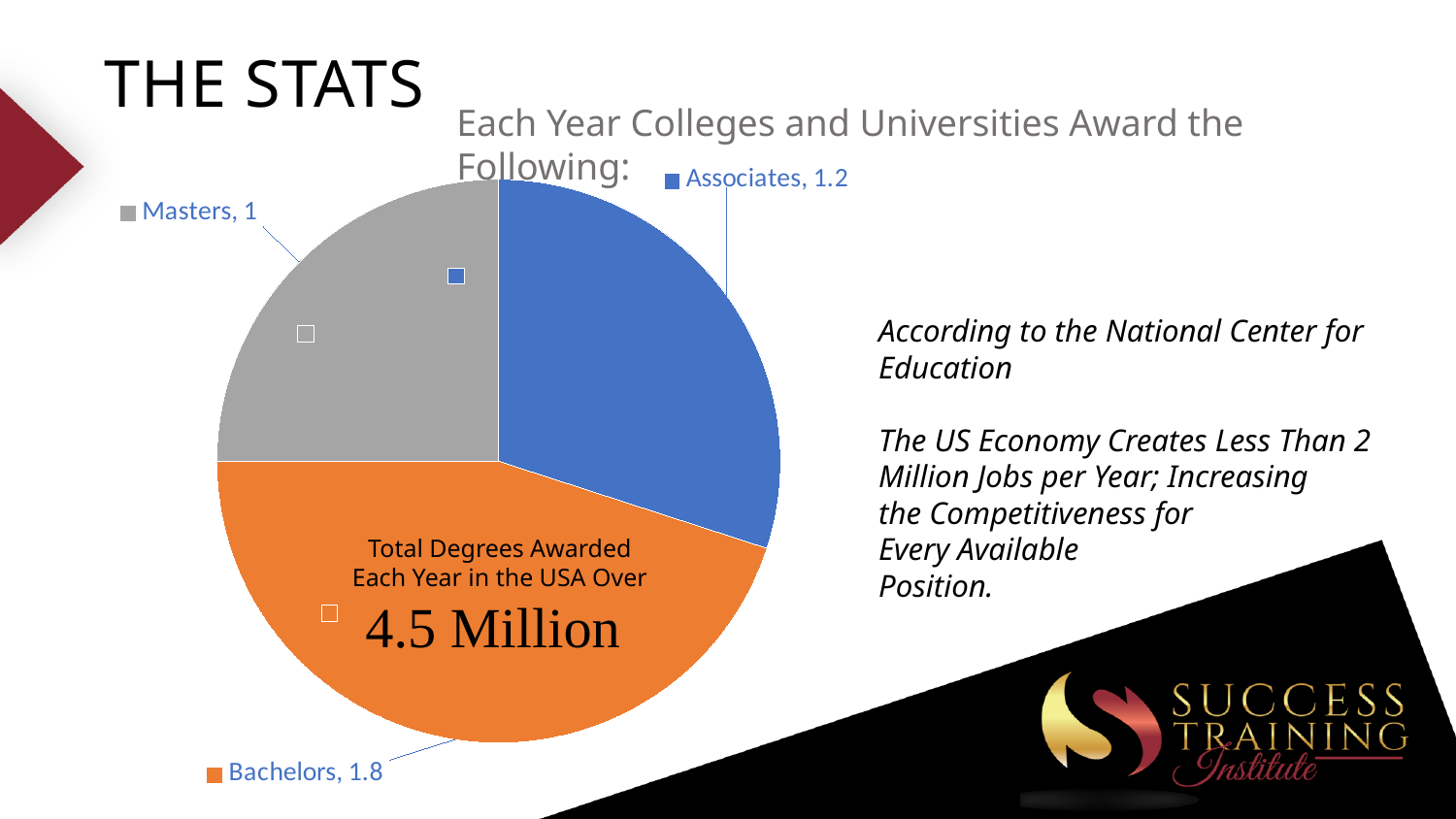
Which is larger, the value for Bachelors or the value for Associates? Bachelors What type of chart is shown on the slide? Pie chart What value is shown for Associates in the pie chart? 1.2 How many categories are shown in the pie chart? 3 What is the difference between the Bachelors value and the Associates value? 0.6 Which category has the smallest slice in the pie chart? Masters What value is shown for Bachelors in the pie chart? 1.8 What colour is the Bachelors slice in the pie chart? Orange Which category has the largest slice in the pie chart? Bachelors What is the difference between the Associates value and the Masters value? 0.2 Which is larger, the value for Associates or the value for Masters? Associates What value is shown for Masters in the pie chart? 1